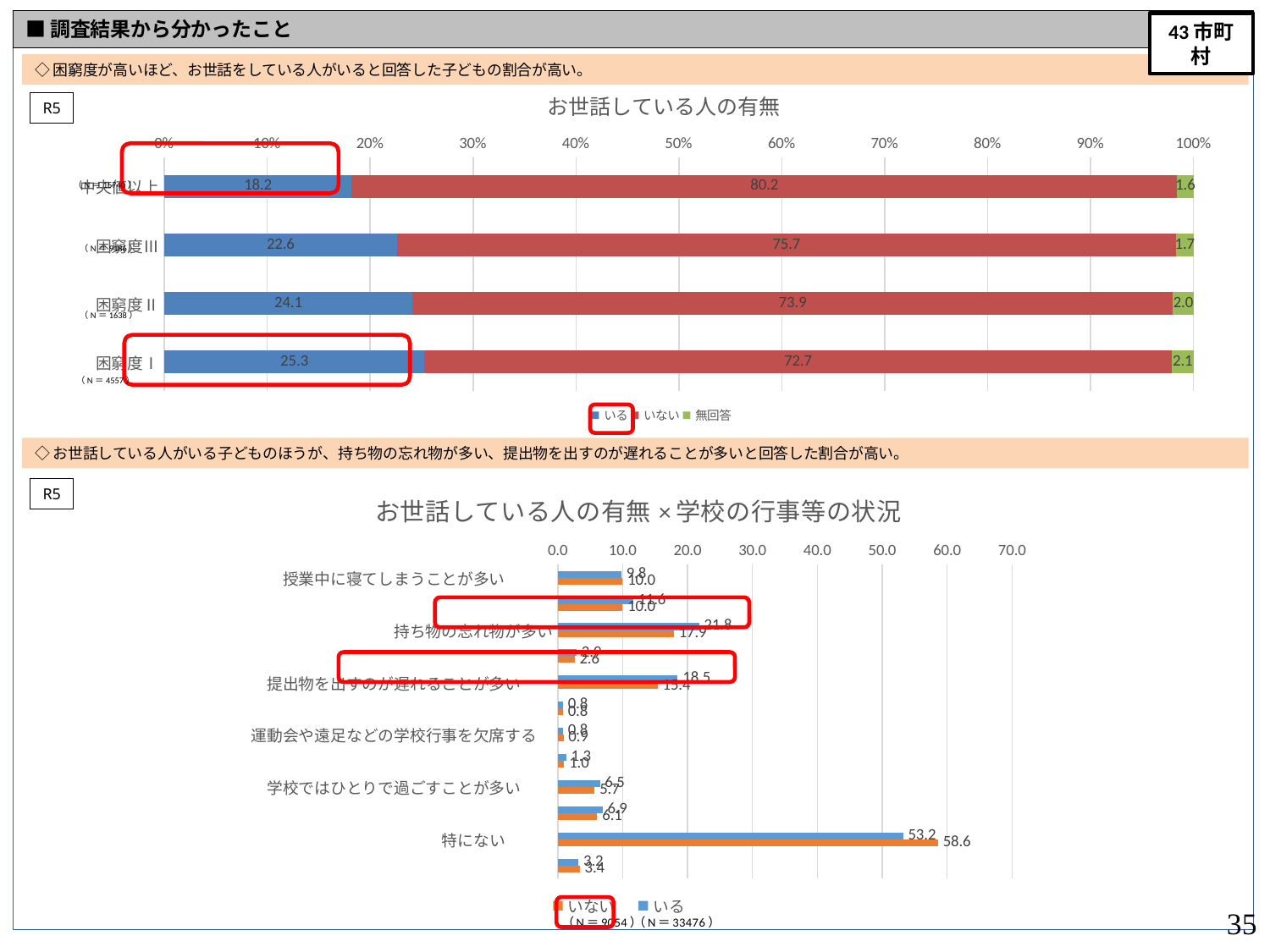
In the top chart titled お世話している人の有無, what is the value for いる for 困窮度Ⅰ? 25.3 In the top chart titled お世話している人の有無, what is the value for 無回答 for 困窮度Ⅱ? 2.0 In the top chart titled お世話している人の有無, what is the value for いない for 中央値以上? 80.2 In the top chart titled お世話している人の有無, what is the difference between the いる values for 困窮度Ⅰ and 中央値以上? 7.1 In the bottom chart titled お世話している人の有無×学校の行事等の状況, what is the difference between いる and いない for 特にない? 5.4 In the bottom chart titled お世話している人の有無×学校の行事等の状況, what is the value for いない for 特にない? 58.6 In the top chart titled お世話している人の有無, which category has the lowest value for いる? 中央値以上 In the bottom chart titled お世話している人の有無×学校の行事等の状況, which is larger for 提出物を出すのが遅れることが多い, いる or いない? いる In the bottom chart titled お世話している人の有無×学校の行事等の状況, what is the value for いる for 持ち物の忘れ物が多い? 21.8 In the top chart titled お世話している人の有無, how many series does the legend list? 3 In the top chart titled お世話している人の有無, what kind of chart is it? Stacked bar chart In the top chart titled お世話している人の有無, which category has the highest value for いる? 困窮度Ⅰ